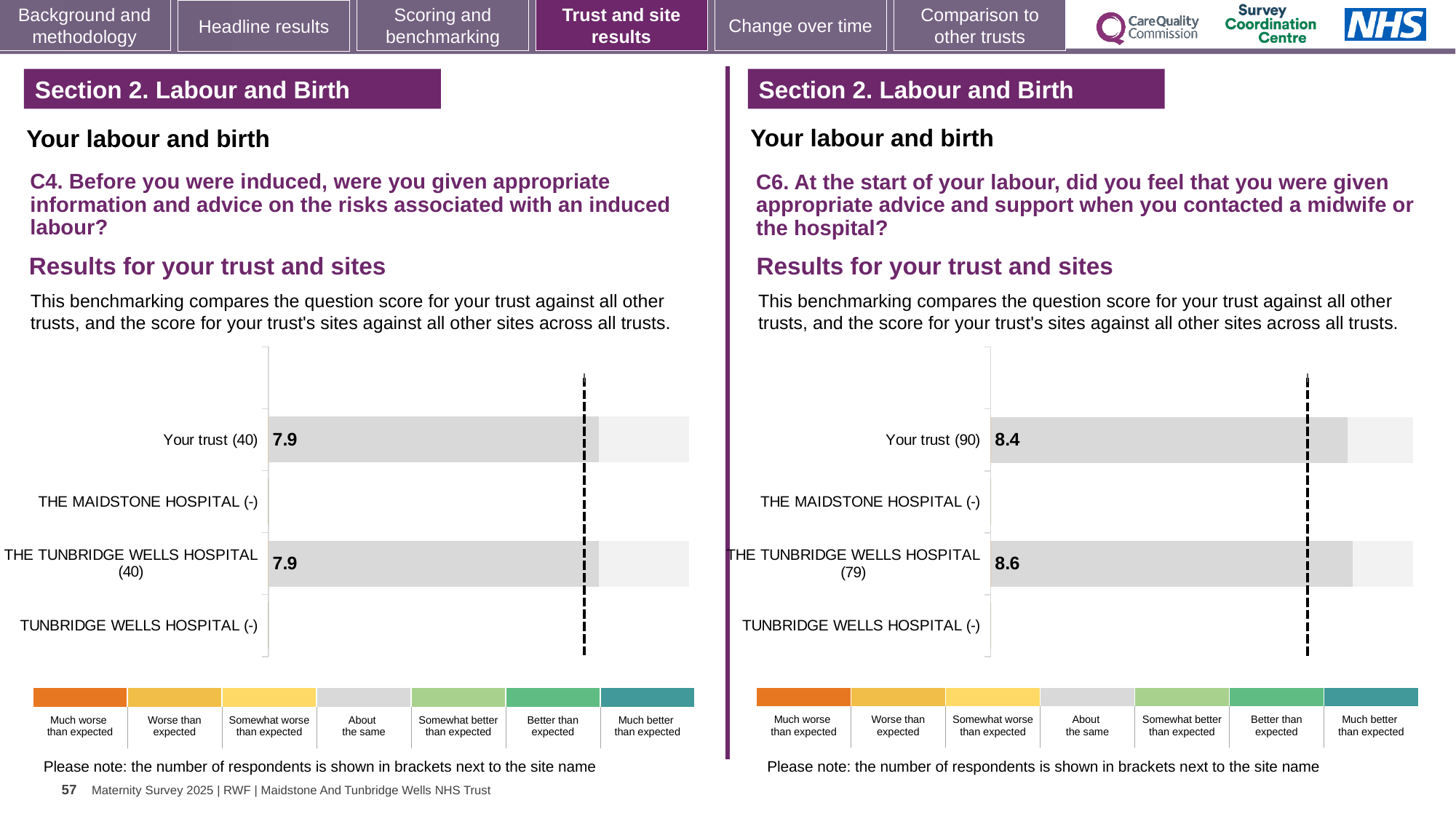
In the right chart (C6), which has the higher score: Your trust (90) or THE TUNBRIDGE WELLS HOSPITAL (79)? THE TUNBRIDGE WELLS HOSPITAL (79) In the right chart (C6), what is the score for THE TUNBRIDGE WELLS HOSPITAL (79)? 8.6 In the right chart (C6), how many respondents are shown in brackets for THE TUNBRIDGE WELLS HOSPITAL? 79 In the right chart (C6), what is the score for Your trust (90)? 8.4 What kind of chart is used in the left chart (C4)? Bar chart In the right chart (C6), how many categories are listed on the vertical axis? 4 In the left chart (C4), how many respondents are shown in brackets for Your trust? 40 In the left chart (C4), what is the score for THE TUNBRIDGE WELLS HOSPITAL (40)? 7.9 In the right chart (C6), what is the difference between the score for THE TUNBRIDGE WELLS HOSPITAL (79) and the score for Your trust (90)? 0.2 In the left chart (C4), how many categories in the legend below the chart describe the benchmarking bands? 7 In the left chart (C4), how many categories are listed on the vertical axis? 4 In the left chart (C4), what is the score for Your trust (40)? 7.9